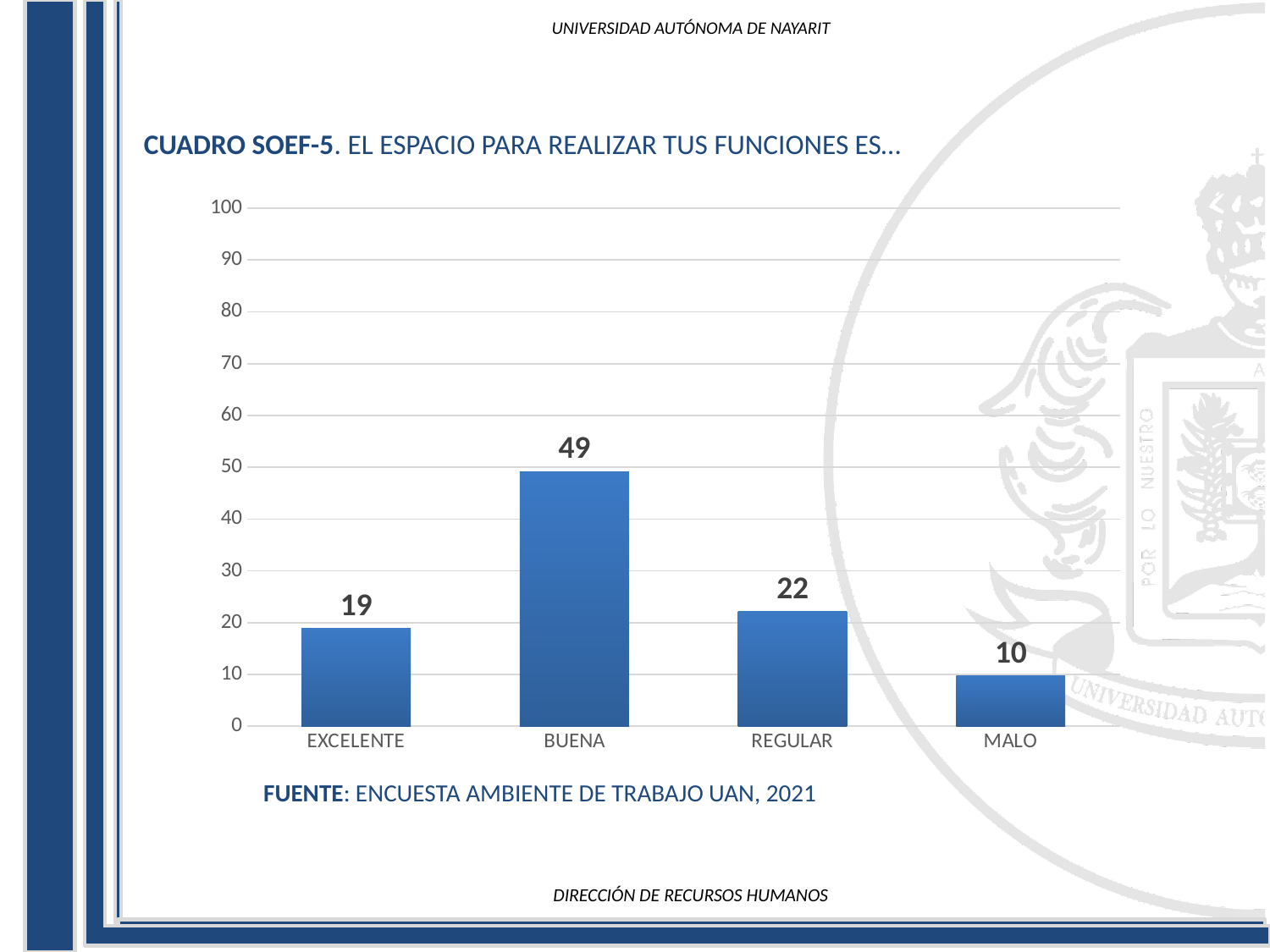
Which category has the lowest value? MALO How many categories are shown on the x axis? 4 What is the value for MALO? 10 What kind of chart is shown on the slide? bar chart Is the value for BUENA greater or less than 40? greater What is the difference between the values for BUENA and REGULAR? 27 What is the maximum value shown on the y axis? 100 What is the value for EXCELENTE? 19 Which category has the highest value? BUENA What source is cited below the chart? ENCUESTA AMBIENTE DE TRABAJO UAN, 2021 What is the value for BUENA? 49 Which is larger, the value for EXCELENTE or the value for REGULAR? REGULAR